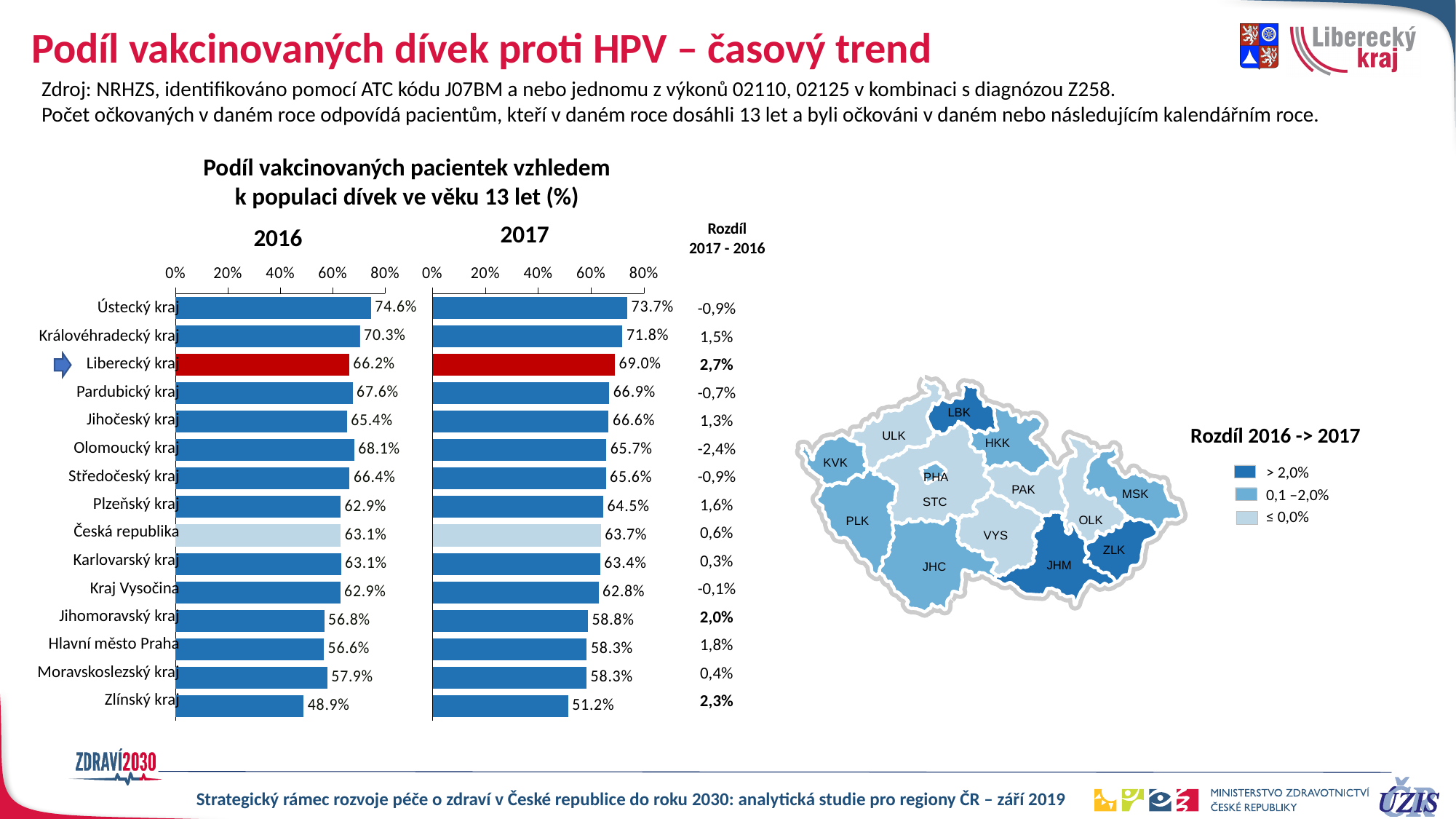
In the 2016 chart, which category has the highest value? Ústecký kraj In the 2017 chart, what is the value for Zlínský kraj? 51.2% In the 2017 chart, is the value for Ústecký kraj greater or less than 60%? greater In the 2016 chart, what is the value for Liberecký kraj? 66.2% In the 2017 chart, which category has the lowest value? Zlínský kraj What kind of chart is used to show the 2016 and 2017 values? Bar chart In the 2017 chart, what is the value for Česká republika? 63.7% How many categories are shown in the 2016 chart? 15 In the 2016 chart, which bar is highlighted in red? Liberecký kraj What is the title of the chart on the left side of the slide? Podíl vakcinovaných pacientek vzhledem k populaci dívek ve věku 13 let (%) What is the difference between the 2017 and 2016 values for Liberecký kraj? 2,7% In the 2016 chart, which is larger: the value for Olomoucký kraj or the value for Pardubický kraj? Olomoucký kraj